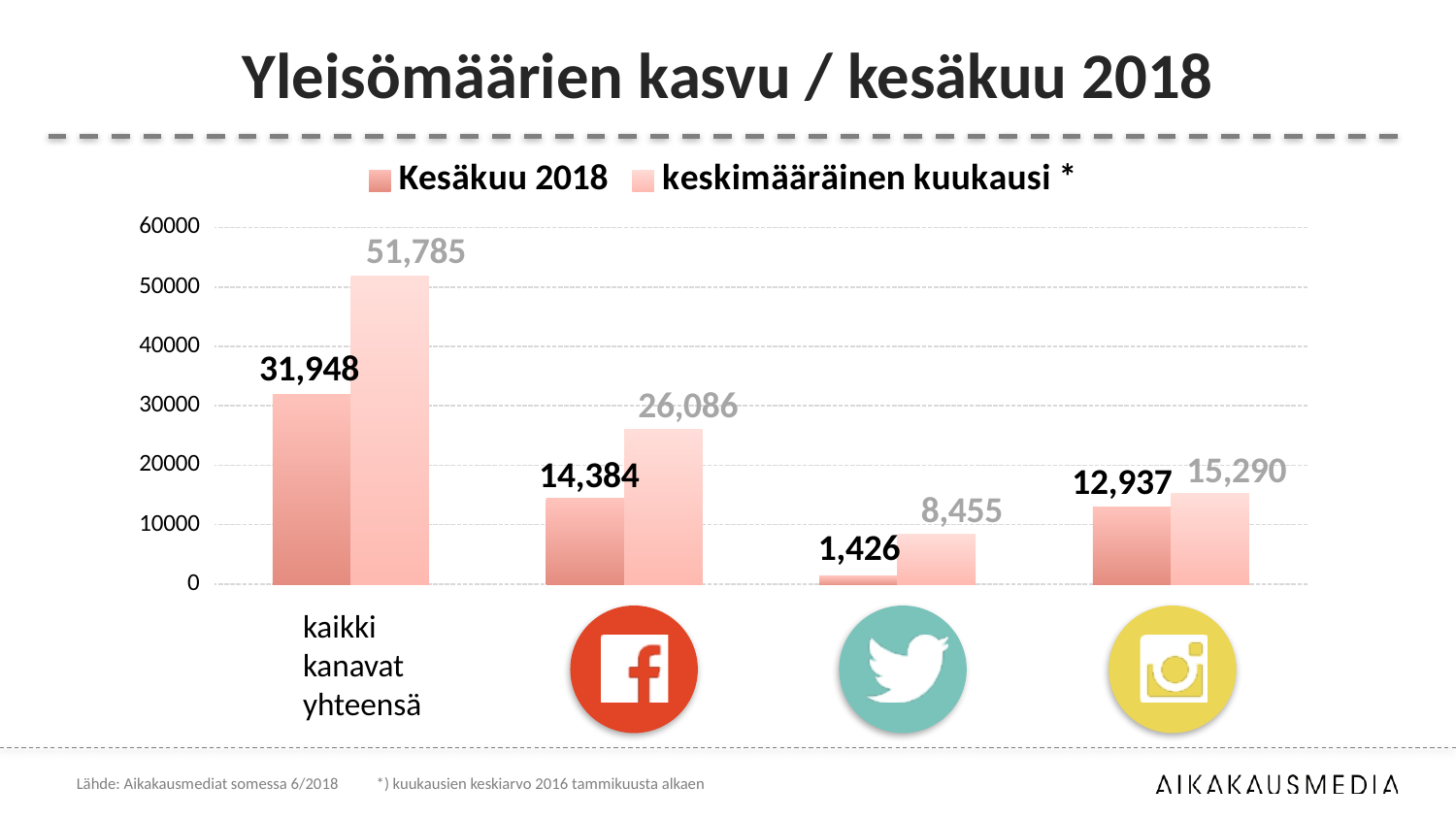
What is the value for 'keskimääräinen kuukausi *' in the 'kaikki kanavat yhteensä' category? 51,785 How many series does the chart legend list? 2 What is the Kesäkuu 2018 value for the Facebook category? 14,384 Which category has the lowest Kesäkuu 2018 value? Twitter What is the title of the slide? Yleisömäärien kasvu / kesäkuu 2018 What is the 'keskimääräinen kuukausi *' value for the Twitter category? 8,455 How many categories are shown on the x axis of the chart? 4 Which is larger for the Instagram category: the Kesäkuu 2018 value or the 'keskimääräinen kuukausi *' value? keskimääräinen kuukausi * What kind of chart is shown on the slide? Bar chart What is the Kesäkuu 2018 value for the Instagram category? 12,937 What is the value for Kesäkuu 2018 in the 'kaikki kanavat yhteensä' category? 31,948 What is the difference between the 'keskimääräinen kuukausi *' and Kesäkuu 2018 values for the Facebook category? 11,702